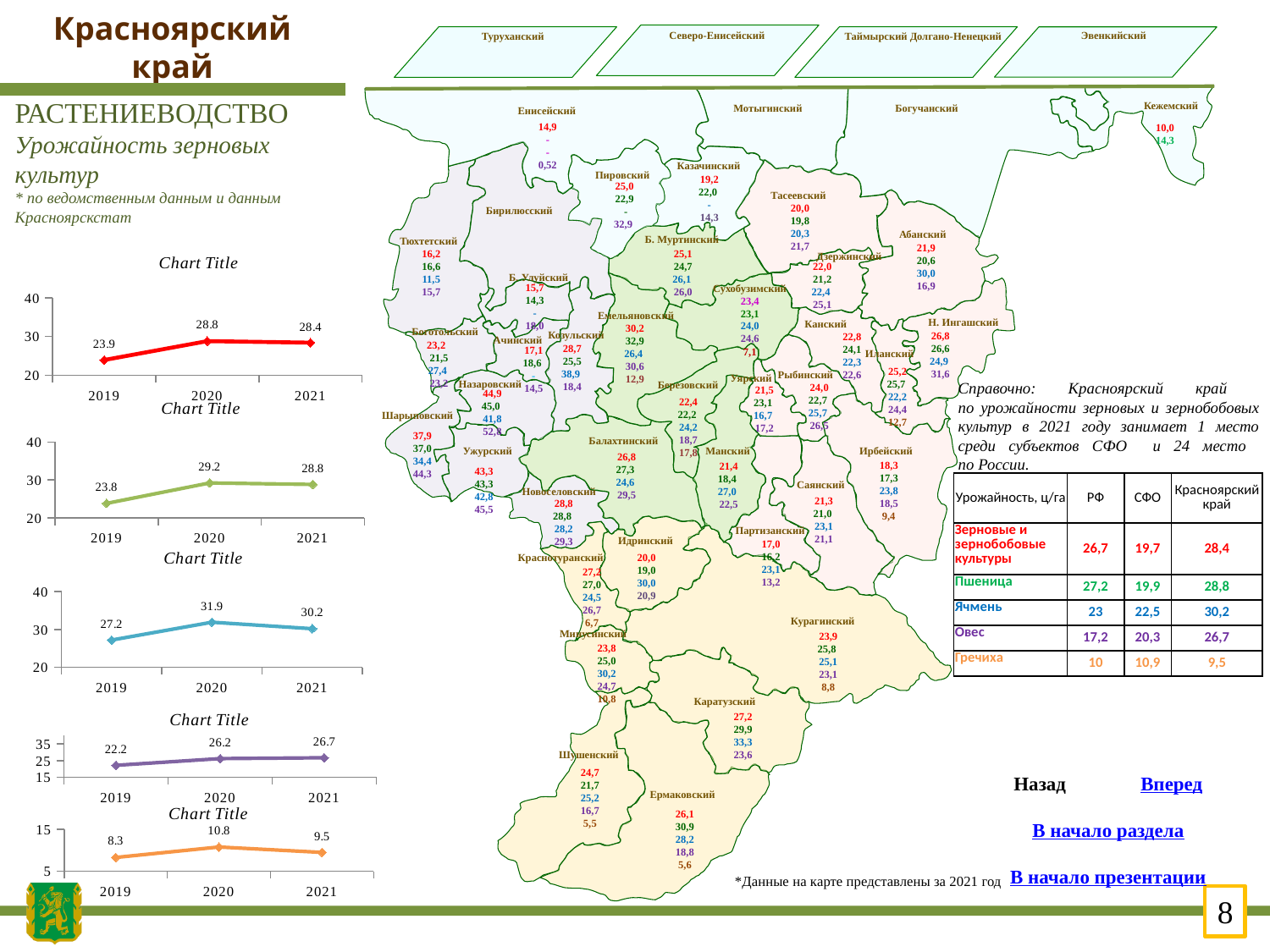
How many data points are plotted in the topmost line chart on the left? 3 In the fourth line chart from the top on the left (purple line), what is the value for 2019? 22.2 In the third line chart from the top on the left (blue line), what is the value for 2019? 27.2 In the topmost line chart on the left (red line), which year has the lowest value? 2019 In the second line chart from the top on the left (green line), what is the value for 2021? 28.8 In the bottom line chart on the left (orange line), what is the difference between the 2020 and 2021 values? 1.3 What type of chart is the bottom chart on the left side of the slide? Line chart In the third line chart from the top on the left (blue line), which year has the highest value? 2020 In the second line chart from the top on the left (green line), what is the difference between the 2020 and 2019 values? 5.4 In the fourth line chart from the top on the left (purple line), is the value for 2021 larger than the value for 2020? Yes In the topmost line chart on the left (red line), what is the value for 2020? 28.8 In the bottom line chart on the left (orange line), what is the value for 2020? 10.8